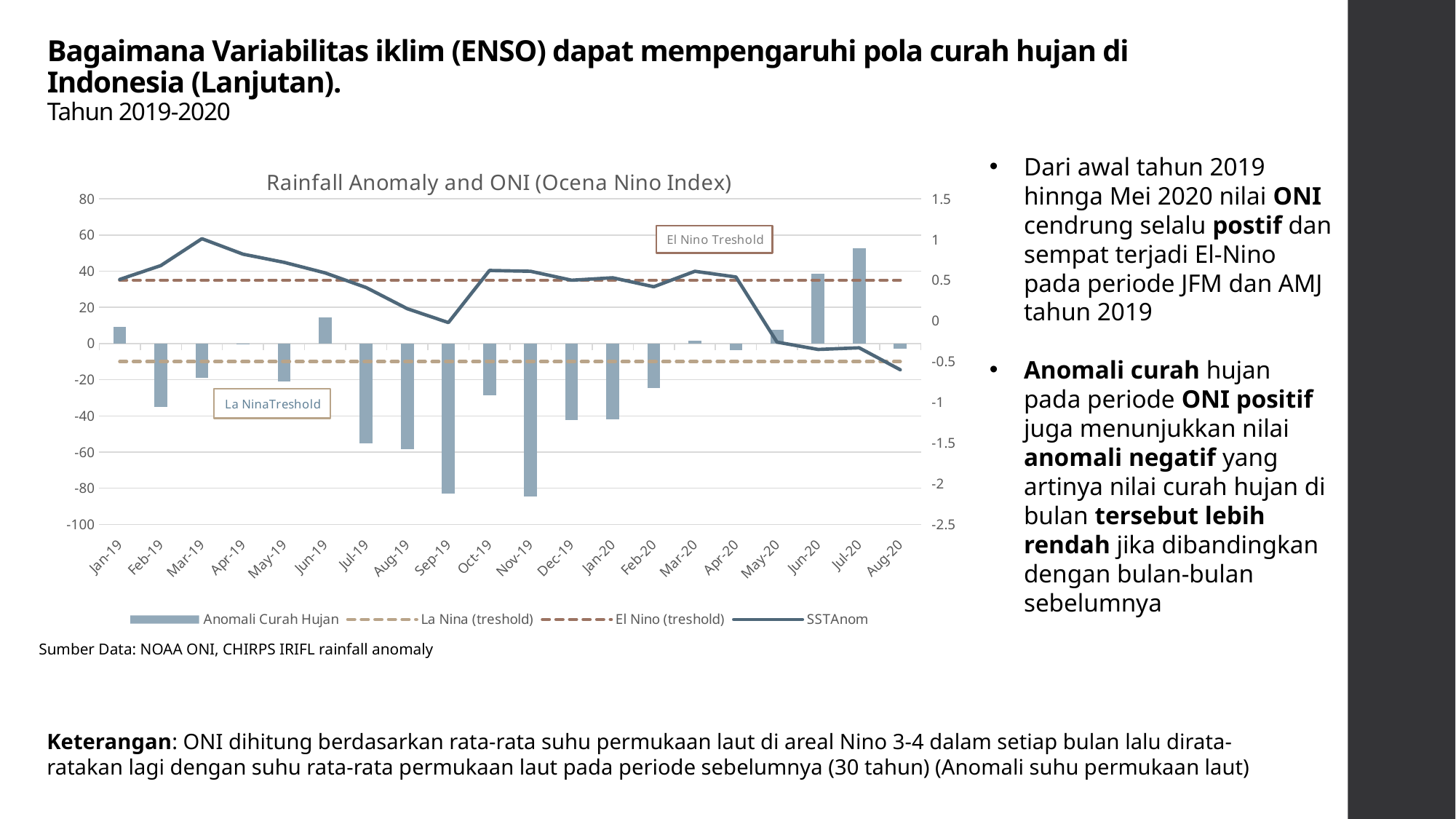
Which month has the highest Anomali Curah Hujan bar? Jul-20 Which month has a larger Anomali Curah Hujan value, Jun-20 or Jul-20? Jul-20 Is the Anomali Curah Hujan value for Jul-20 greater or less than 40? greater Is the Anomali Curah Hujan value for Nov-19 greater or less than -60? less In which month does the SSTAnom line reach its highest value? Mar-19 Is the SSTAnom value for Aug-20 greater or less than 0? less What is the title of the chart? Rainfall Anomaly and ONI (Ocena Nino Index) How many months are shown on the x axis of the chart? 20 How many series does the chart legend list? 4 Does the SSTAnom line rise or fall from Apr-20 to Aug-20? fall What kind of chart is shown on the slide? A combination bar and line chart